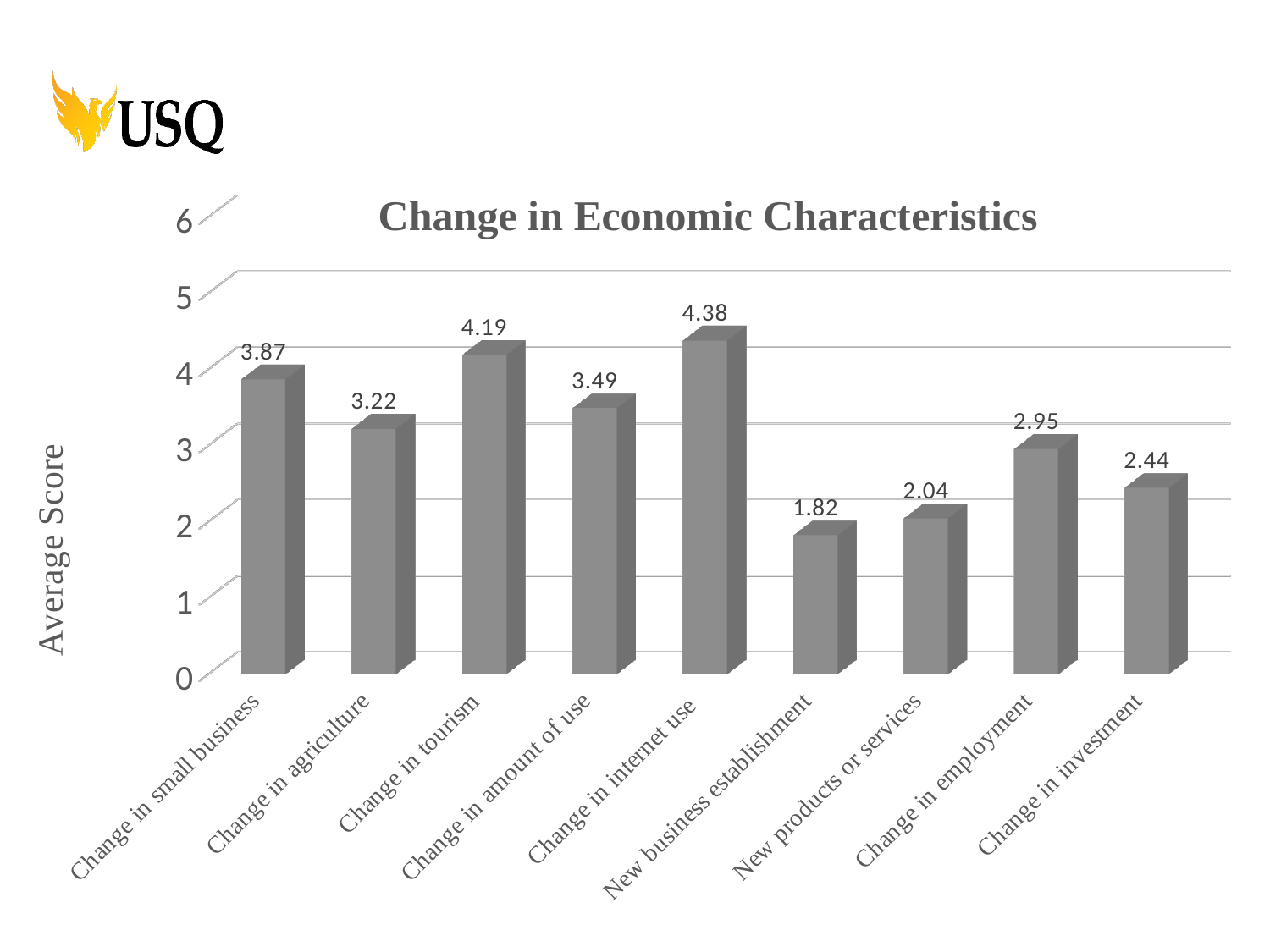
Which category has the highest average score? Change in internet use What kind of chart is shown on the slide? Bar chart What is the average score for Change in employment? 2.95 How many categories are shown in the chart? 9 What is the average score for Change in small business? 3.87 What is the average score for New business establishment? 1.82 What is the difference between the average scores for Change in tourism and Change in agriculture? 0.97 Which category has the lowest average score? New business establishment Is the value for New products or services greater or less than 3? less Which has a higher average score, Change in amount of use or Change in investment? Change in amount of use What is the title of the chart? Change in Economic Characteristics What is the label of the vertical axis? Average Score